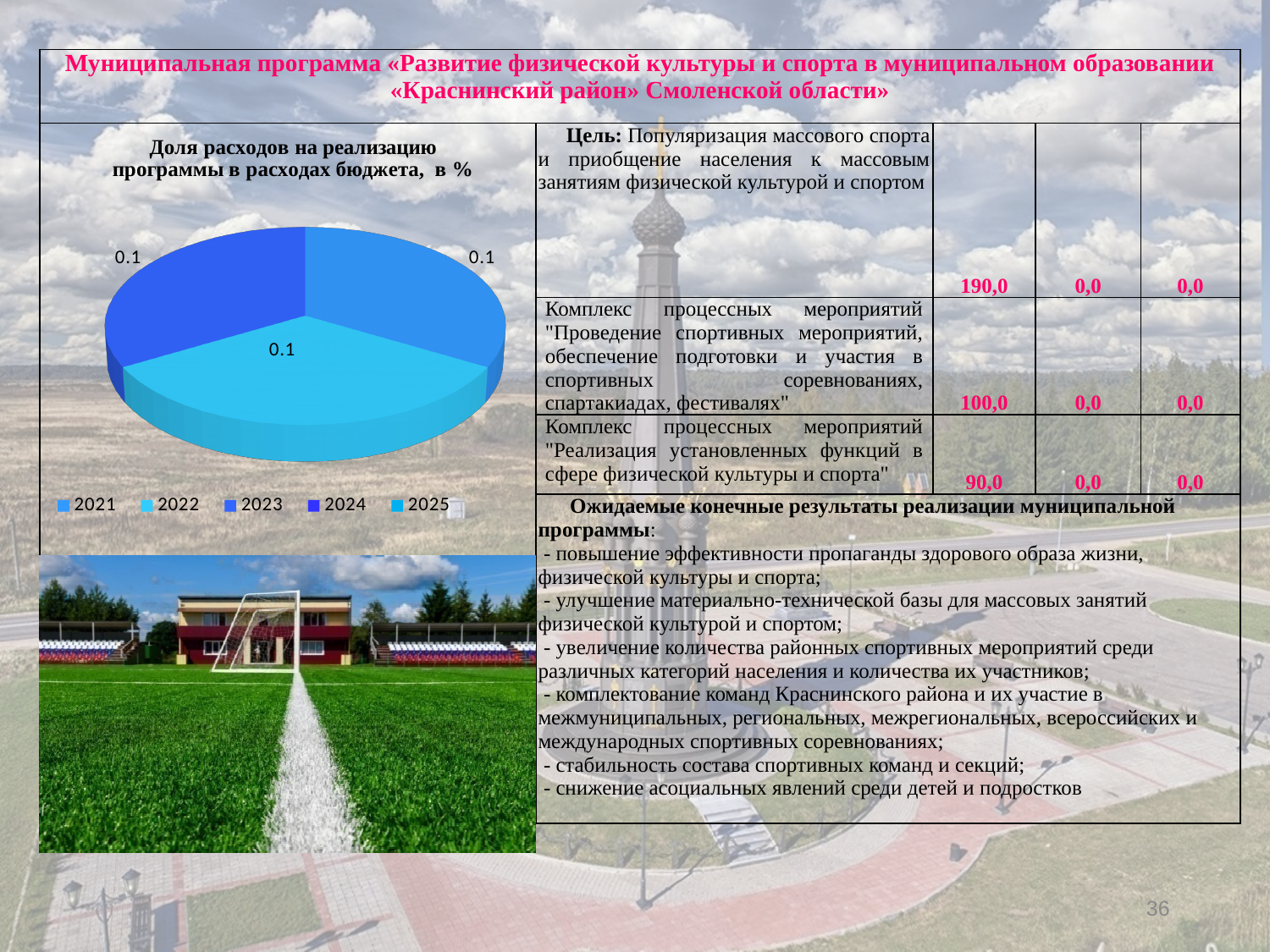
What value is printed on the top-right slice of the pie chart? 0.1 Which year is listed first in the legend of the pie chart? 2021 How many slices with data labels are visible in the pie chart? 3 How many entries does the legend of the pie chart list? 5 What value is printed on the left, dark blue slice of the pie chart? 0.1 What is the difference between the values printed on the 2022 slice and the top-right slice of the pie chart? 0 What is the sum of the three values printed on the pie chart slices? 0.3 Are the three labeled slices of the pie chart equal in value? yes What value is printed on the light cyan slice (2022) of the pie chart? 0.1 What is the title of the pie chart? Доля расходов на реализацию программы в расходах бюджета, в % What kind of chart is shown on the slide? pie chart